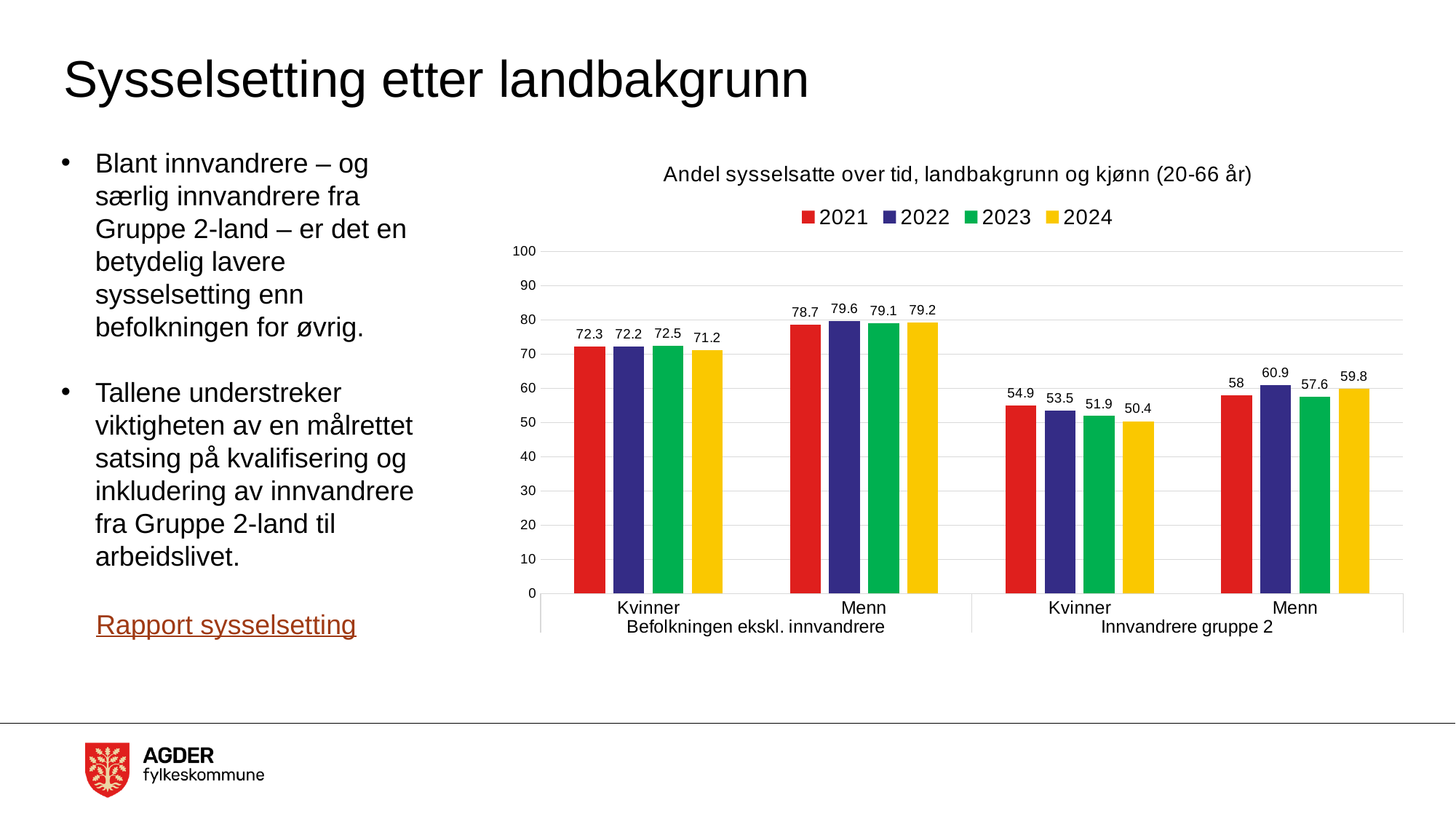
Which colour represents 2024 in the chart? Yellow How many series does the legend list? 4 Which is larger: the 2023 value for Kvinner in Befolkningen ekskl. innvandrere or the 2023 value for Menn in Innvandrere gruppe 2? Kvinner in Befolkningen ekskl. innvandrere What is the 2022 value for Menn in Innvandrere gruppe 2? 60.9 What is the 2021 value for Kvinner in Innvandrere gruppe 2? 54.9 What is the title of the chart? Andel sysselsatte over tid, landbakgrunn og kjønn (20-66 år) What is the difference between the 2024 values for Menn and Kvinner in Innvandrere gruppe 2? 9.4 What kind of chart is shown on the slide? Bar chart Which year has the highest value for Menn in Befolkningen ekskl. innvandrere? 2022 Which year has the lowest value for Kvinner in Innvandrere gruppe 2? 2024 What is the 2024 value for Kvinner in Befolkningen ekskl. innvandrere? 71.2 Do the values for Kvinner in Innvandrere gruppe 2 rise or fall from 2021 to 2024? Fall